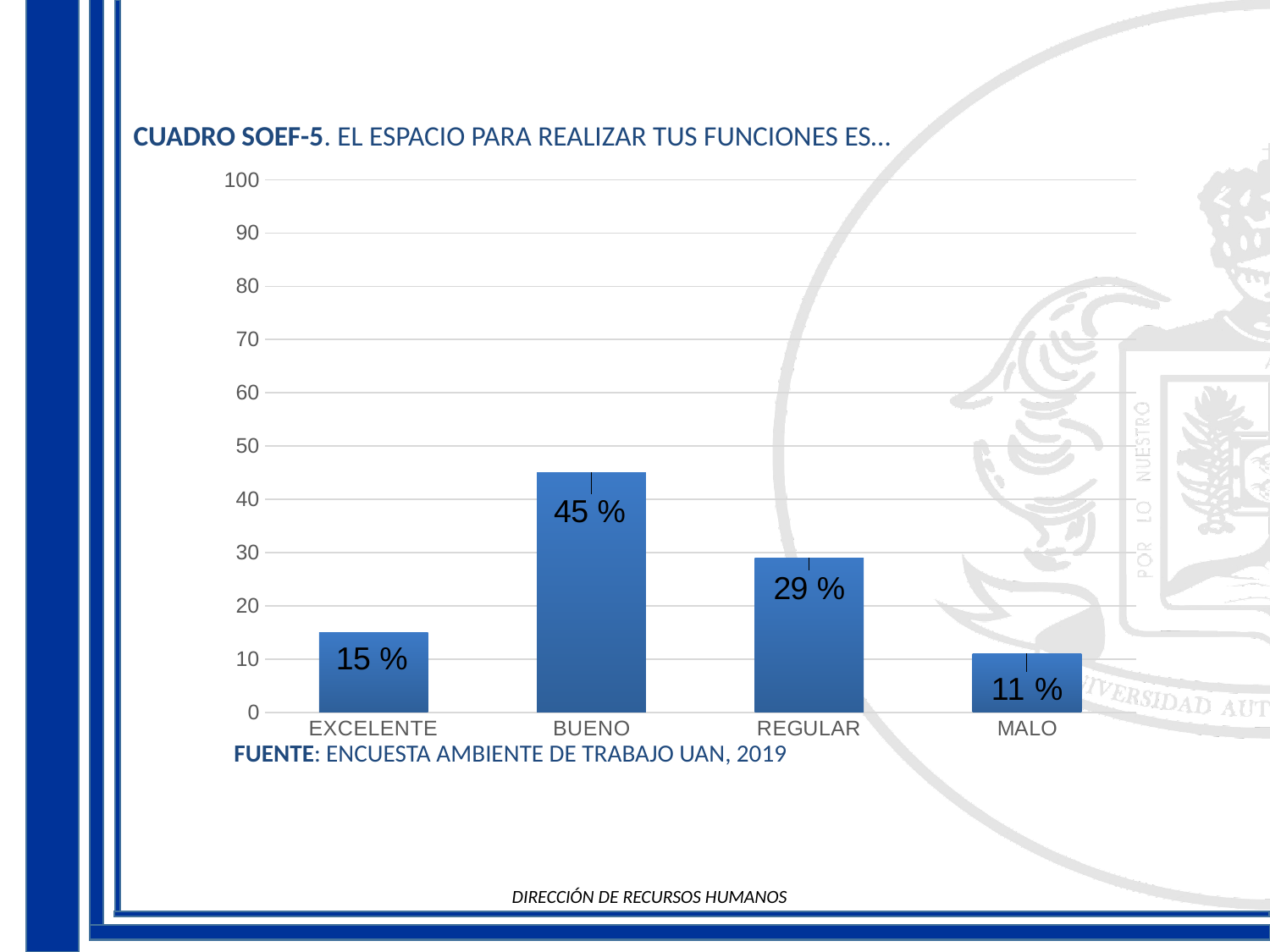
What is the source cited below the chart? ENCUESTA AMBIENTE DE TRABAJO UAN, 2019 What is the value for MALO? 11 % What is the value for BUENO? 45 % What is the value for EXCELENTE? 15 % How many categories are shown on the x axis? 4 Which is larger, the value for EXCELENTE or the value for MALO? EXCELENTE What is the value for REGULAR? 29 % Is the value for BUENO greater or less than 40? greater What is the difference between the values for BUENO and REGULAR? 16 % Which category has the highest value? BUENO What kind of chart is shown on the slide? bar chart Which category has the lowest value? MALO